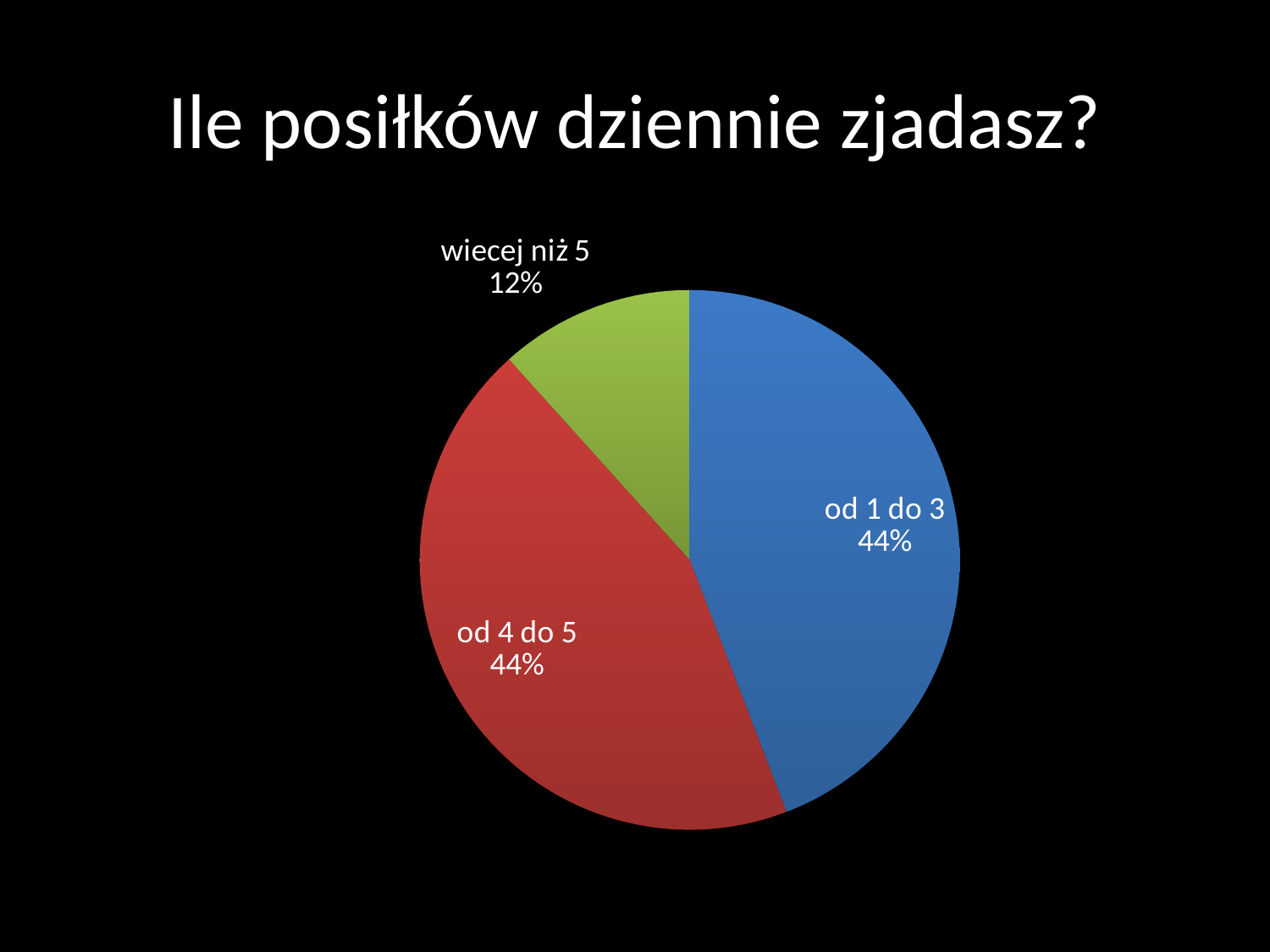
What is the title of the slide? Ile posiłków dziennie zjadasz? What share of the pie does the "od 1 do 3" slice represent? 44% What share of the pie does the "wiecej niż 5" slice represent? 12% What is the difference in percentage points between the "od 1 do 3" slice and the "wiecej niż 5" slice? 32 percentage points Which category has the smallest slice of the pie? wiecej niż 5 What kind of chart is shown on the slide? pie chart What is the combined share of the "od 1 do 3" and "od 4 do 5" slices? 88% What share of the pie does the "od 4 do 5" slice represent? 44% What colour is the "wiecej niż 5" slice? green Which is larger: the "od 4 do 5" slice or the "wiecej niż 5" slice? od 4 do 5 How many slices does the pie chart have? 3